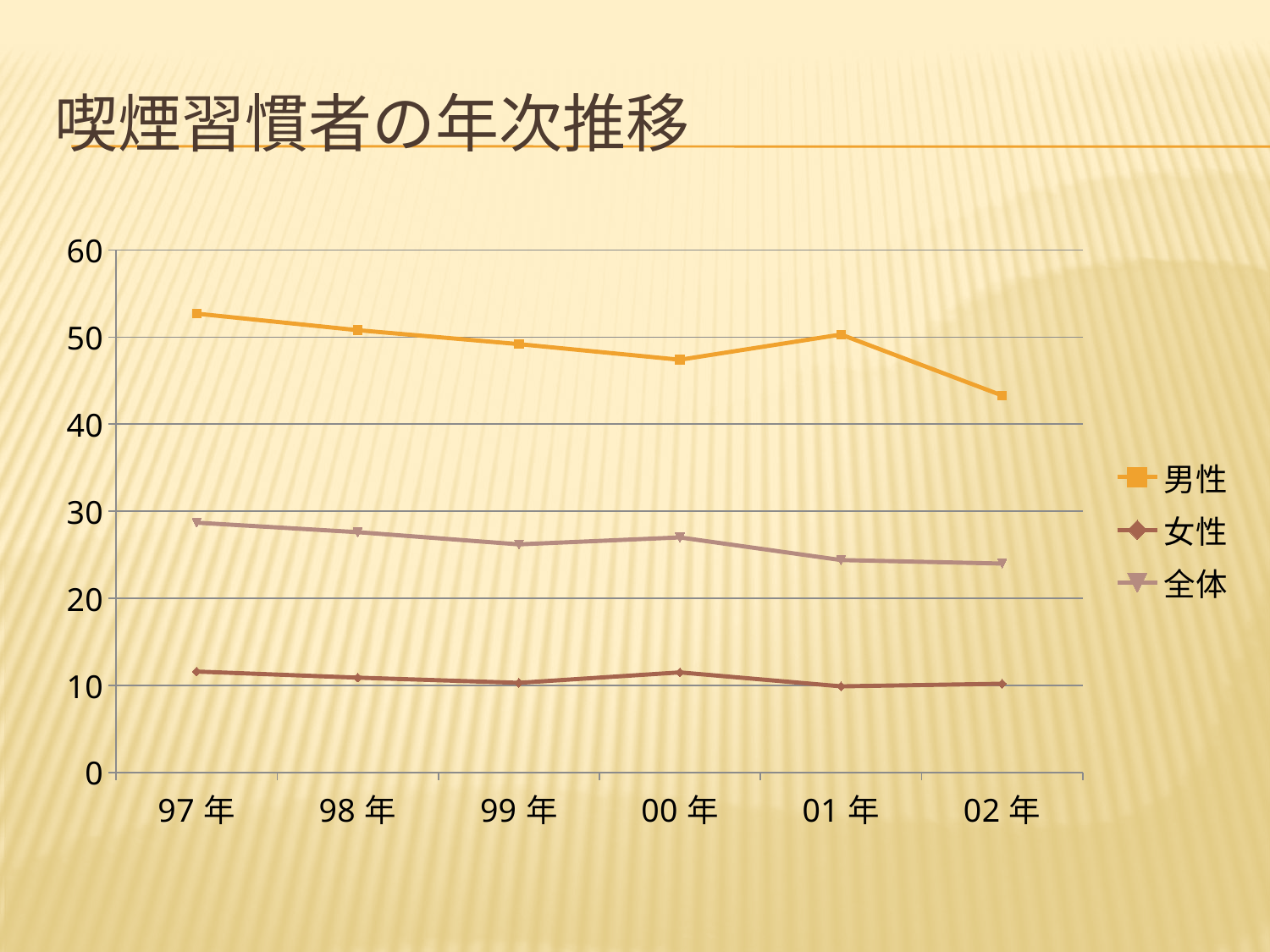
How many years are shown on the x axis? 6 Which series has the highest values across all years? 男性 What kind of chart is shown on the slide? line chart How many series does the legend list? 3 Is the value for 女性 in 97年 greater or less than 10? greater Is the value for 全体 in 97年 greater or less than 30? less In which year is the 男性 series at its lowest? 02年 Is the value for 男性 in 02年 greater or less than 50? less Does the 全体 series generally rise or fall from 97年 to 02年? fall What is the title of the chart on the slide? 喫煙習慣者の年次推移 In which year is the 男性 series at its highest? 97年